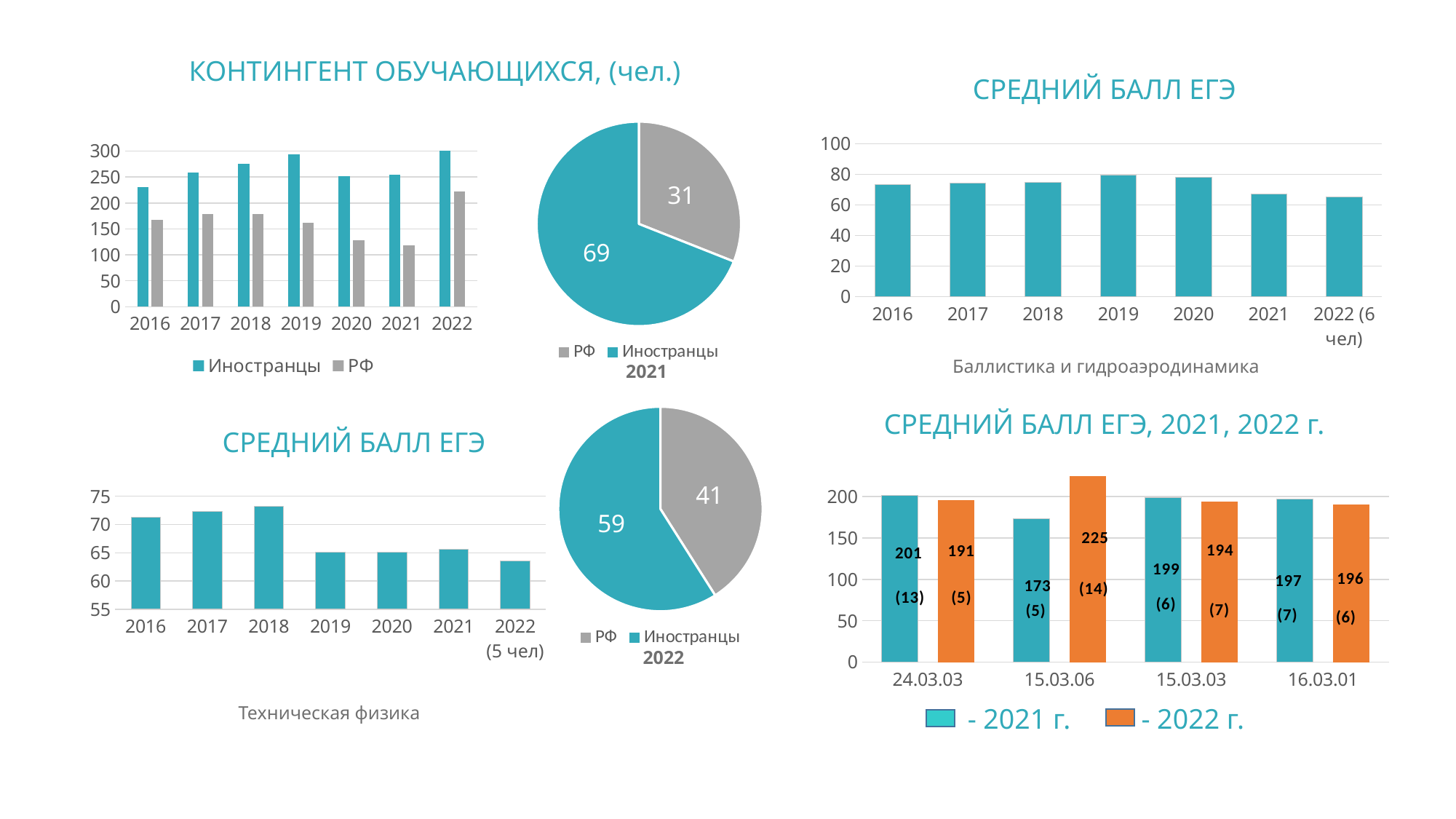
In the 2021 pie chart (Иностранцы vs РФ), what value is shown for Иностранцы? 69 In the chart 'СРЕДНИЙ БАЛЛ ЕГЭ, 2021, 2022 г.', what is the difference between the 2021 and 2022 values for 24.03.03? 10 In the chart 'КОНТИНГЕНТ ОБУЧАЮЩИХСЯ, (чел.)', is the value for Иностранцы in 2022 greater or less than 250? greater In the 2022 pie chart (Иностранцы vs РФ), what value is shown for РФ? 41 In the chart 'СРЕДНИЙ БАЛЛ ЕГЭ, 2021, 2022 г.', which category has the lowest 2021 value? 15.03.06 In the chart 'СРЕДНИЙ БАЛЛ ЕГЭ, 2021, 2022 г.', what is the 2022 value for 15.03.06? 225 How many years are shown on the x axis of the chart 'КОНТИНГЕНТ ОБУЧАЮЩИХСЯ, (чел.)'? 7 How many series does the legend of the chart 'СРЕДНИЙ БАЛЛ ЕГЭ, 2021, 2022 г.' list? 2 In the chart 'СРЕДНИЙ БАЛЛ ЕГЭ, 2021, 2022 г.', which category has the highest 2022 value? 15.03.06 In the chart 'СРЕДНИЙ БАЛЛ ЕГЭ, 2021, 2022 г.', for 15.03.03, which year has the larger value, 2021 or 2022? 2021 What kind of chart is the 'СРЕДНИЙ БАЛЛ ЕГЭ' chart for Баллистика и гидроаэродинамика (top right)? bar chart In the 'СРЕДНИЙ БАЛЛ ЕГЭ' chart for Техническая физика (bottom left), is the value for 2019 greater or less than 70? less